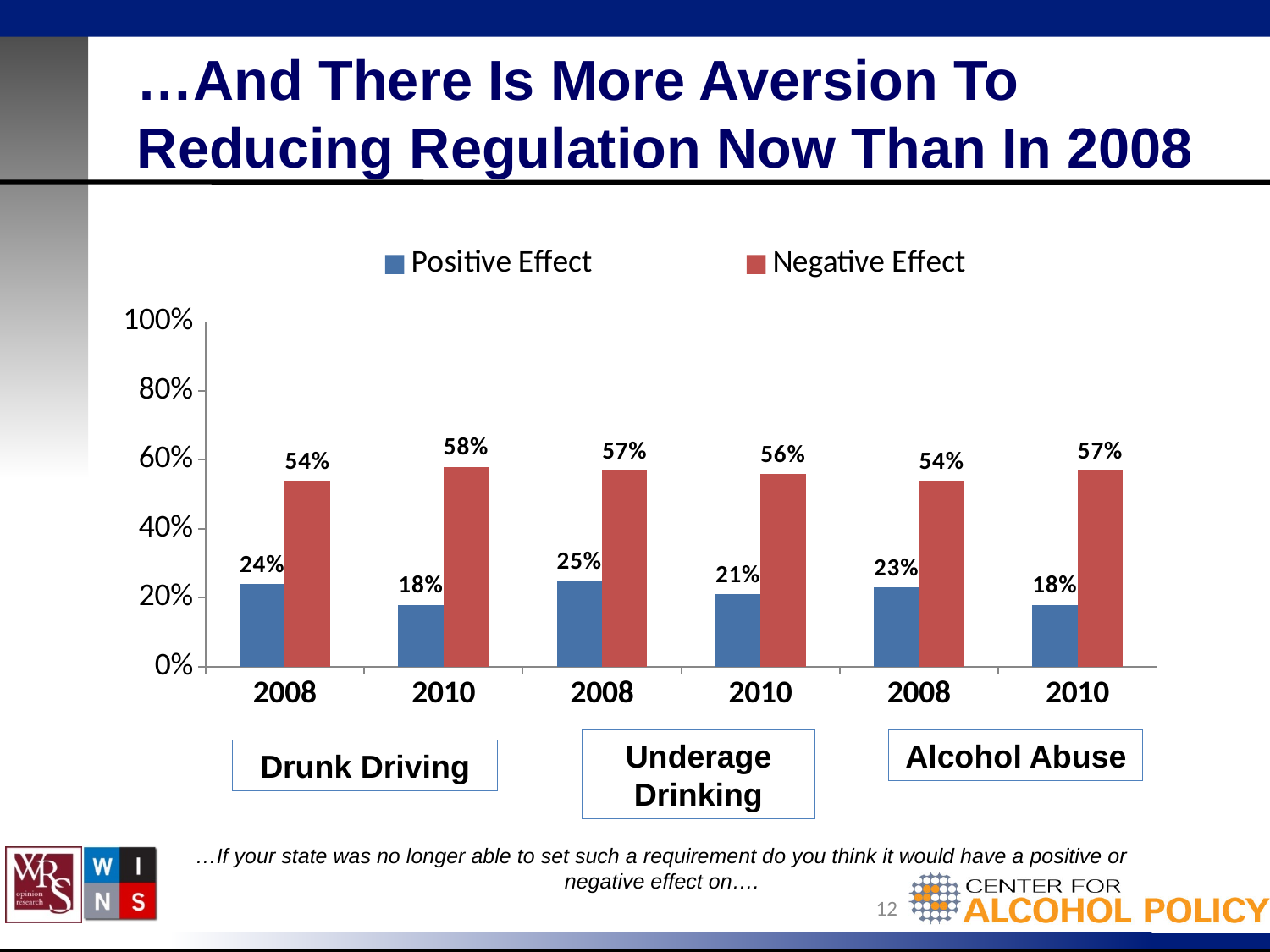
What is the difference between the Negative Effect and Positive Effect values for Alcohol Abuse in 2008? 31% What is the Negative Effect value for Underage Drinking in 2010? 56% What is the Positive Effect value for Alcohol Abuse in 2010? 18% What kind of chart is shown on the slide? bar chart What is the Positive Effect value for Drunk Driving in 2008? 24% How many bars are plotted in the chart? 12 Which category and year has the highest Negative Effect value? Drunk Driving 2010 What colour represents the Negative Effect series? red Is the Positive Effect value for Underage Drinking in 2010 larger or smaller than the Positive Effect value for Underage Drinking in 2008? smaller What is the Negative Effect value for Drunk Driving in 2010? 58% Which category and year has the highest Positive Effect value? Underage Drinking 2008 How many series does the legend list? 2